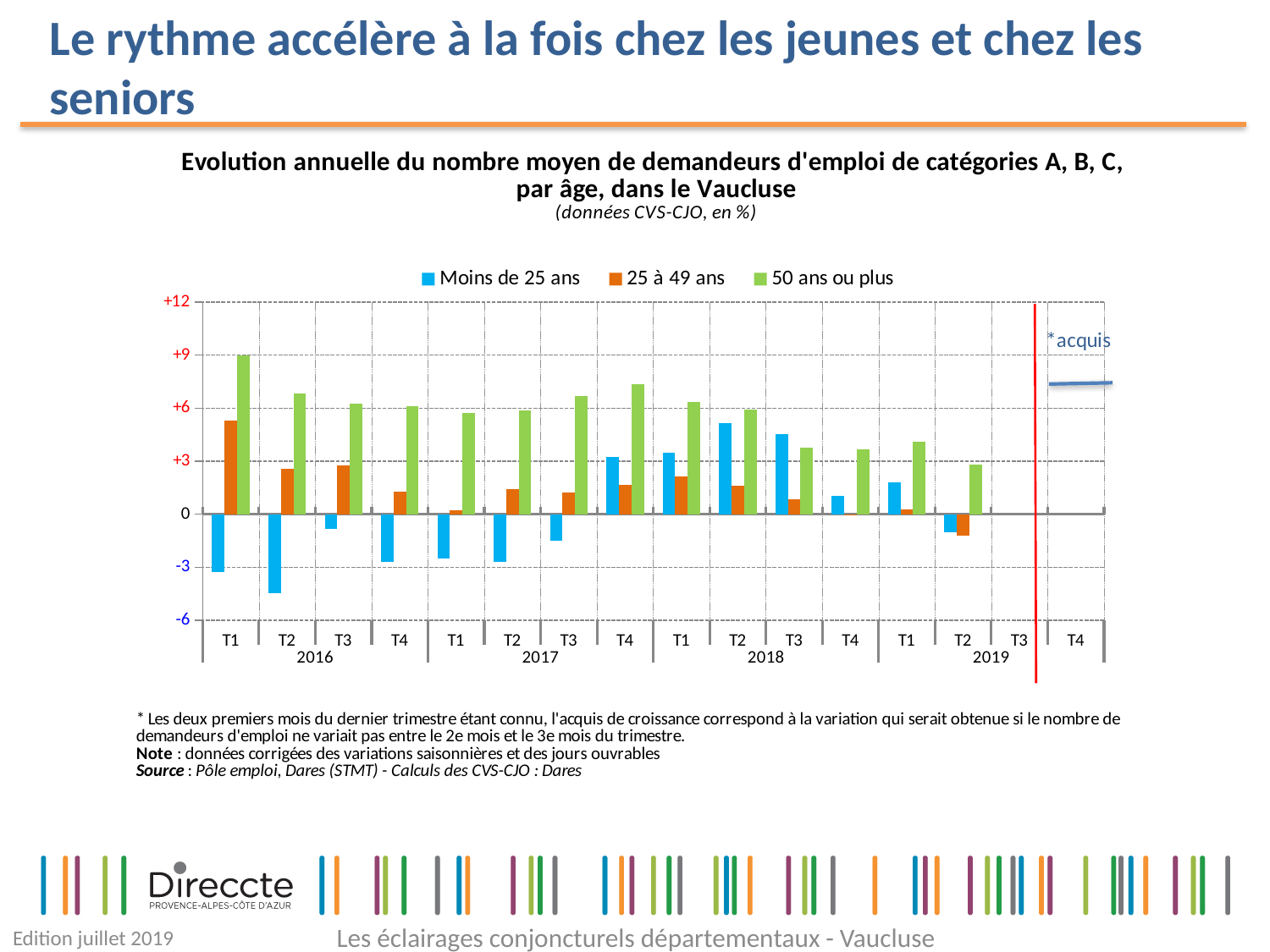
In T1 2016, which is larger: the value for '25 à 49 ans' or for '50 ans ou plus'? 50 ans ou plus Is the value for 'Moins de 25 ans' in T3 2018 greater or less than +3? greater Is the value for '50 ans ou plus' in T4 2017 greater or less than +6? greater Which series is shown in green in the legend? 50 ans ou plus Is the value for 'Moins de 25 ans' in T2 2016 greater or less than -3? less In which quarter is the '50 ans ou plus' bar the highest? T1 2016 How many series does the legend list? 3 What kind of chart is shown on the slide? bar chart How many years are labeled along the x axis? 4 In which quarter is the 'Moins de 25 ans' bar the lowest? T2 2016